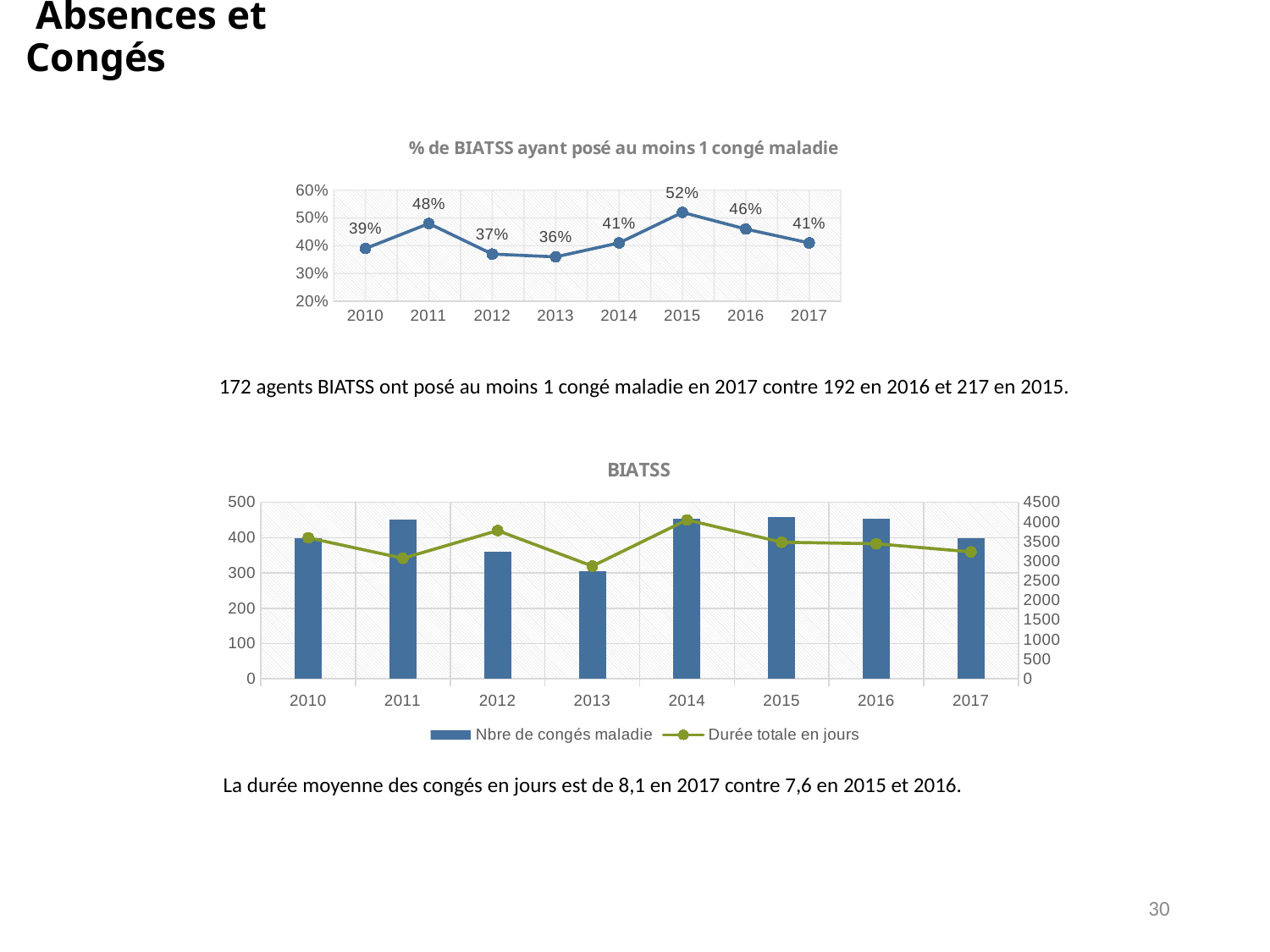
In the chart '% de BIATSS ayant posé au moins 1 congé maladie', does the value rise or fall from 2015 to 2017? fall In the chart '% de BIATSS ayant posé au moins 1 congé maladie', which is larger, the value for 2011 or the value for 2016? 2011 In the chart titled 'BIATSS', is the 'Nbre de congés maladie' bar for 2013 greater or less than 400? less In the chart titled 'BIATSS', how many series does the legend list? 2 In the chart '% de BIATSS ayant posé au moins 1 congé maladie', how many years are plotted? 8 In the chart '% de BIATSS ayant posé au moins 1 congé maladie', what is the difference between the values for 2015 and 2017? 11% In the chart '% de BIATSS ayant posé au moins 1 congé maladie', which year has the highest value? 2015 In the chart titled 'BIATSS', which year has the highest point for 'Durée totale en jours'? 2014 In the chart '% de BIATSS ayant posé au moins 1 congé maladie', what is the value for 2010? 39% In the chart '% de BIATSS ayant posé au moins 1 congé maladie', which year has the lowest value? 2013 In the chart '% de BIATSS ayant posé au moins 1 congé maladie', what is the value for 2015? 52% In the chart titled 'BIATSS', which year has the lowest bar for 'Nbre de congés maladie'? 2013